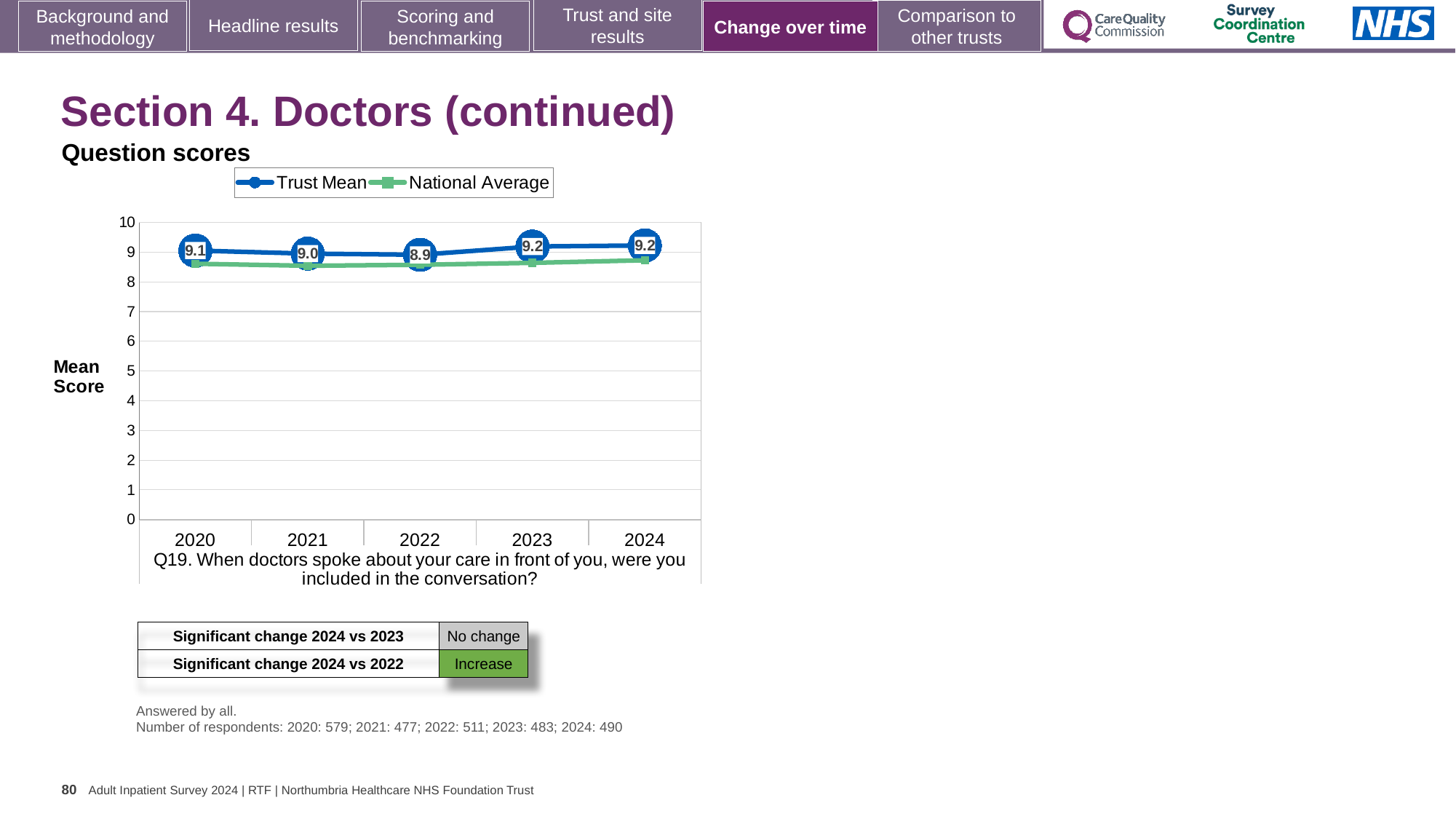
In 2024, which is higher: the Trust Mean or the National Average? Trust Mean What is the Trust Mean score for 2020? 9.1 What is the Trust Mean score for 2022? 8.9 Is the National Average value for 2020 greater or less than 8? greater What is the Trust Mean score for 2024? 9.2 What kind of chart is shown? line chart How many series does the legend list? 2 How many years are shown on the x axis? 5 What is the difference between the Trust Mean score in 2024 and in 2022? 0.3 In which year is the Trust Mean score lowest? 2022 What is the label of the y axis? Mean Score Does the Trust Mean rise or fall from 2022 to 2024? rise